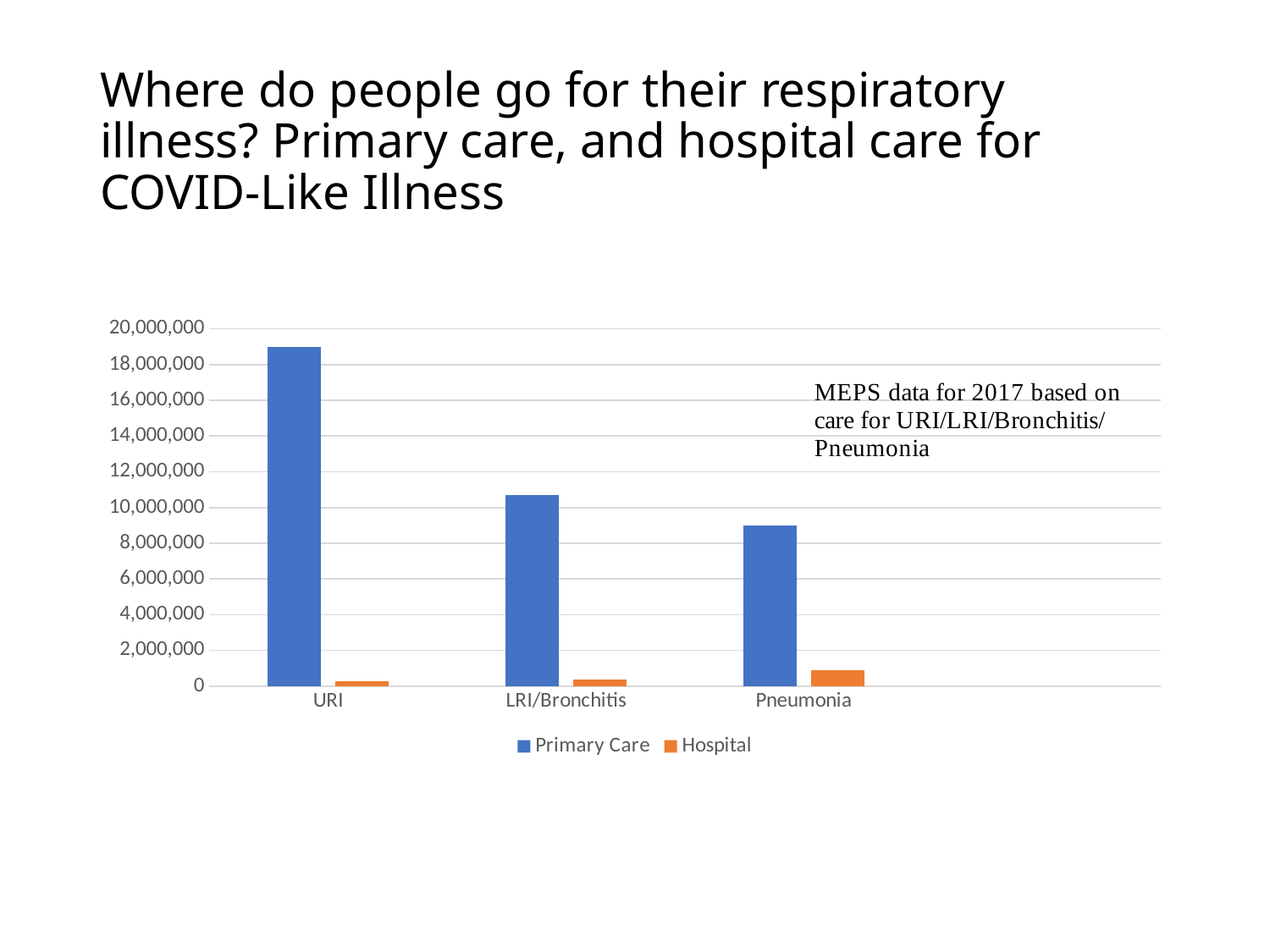
Do the Primary Care values rise or fall from URI to Pneumonia along the x axis? fall Which is larger for Pneumonia, the Primary Care value or the Hospital value? Primary Care Which category has the highest Hospital value? Pneumonia Which category has the lowest Primary Care value? Pneumonia Is the Hospital value for Pneumonia greater or less than 2,000,000? less How many categories are shown on the x axis? 3 What kind of chart is shown on the slide? bar chart Which category has the highest Primary Care value? URI How many series does the legend list? 2 Is the Primary Care value for URI greater or less than 18,000,000? greater Is the Primary Care value for Pneumonia greater or less than 10,000,000? less